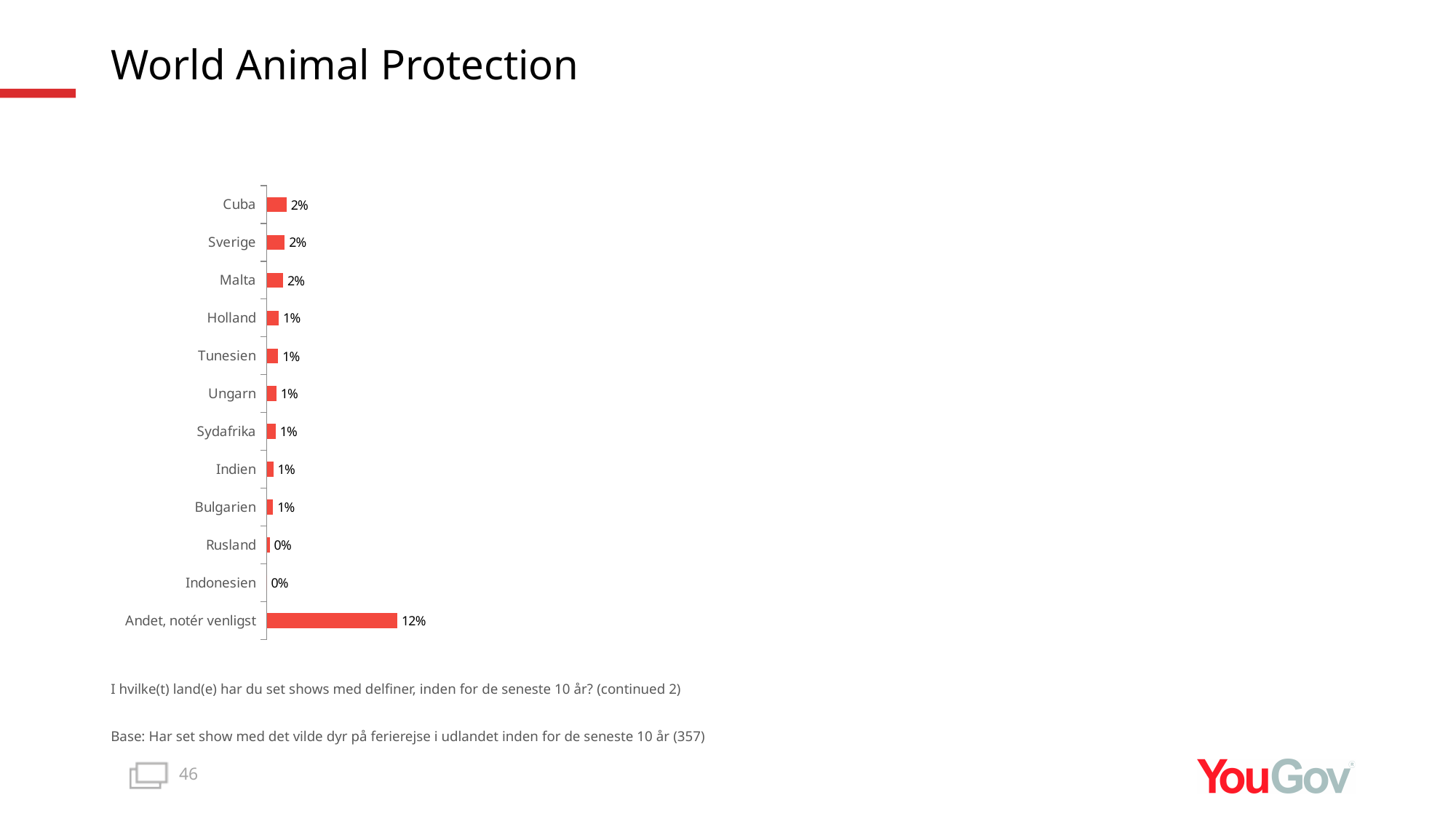
Which category has the highest value? Andet, notér venligst What is the value for Malta? 2% What kind of chart is shown on the slide? Bar chart What is the value for Andet, notér venligst? 12% What is the value for Cuba? 2% What is the value for Indonesien? 0% What colour are the bars in the chart? Red How many categories are shown in the chart? 12 What is the value for Holland? 1% What is the difference between the value for Andet, notér venligst and the value for Cuba? 10 percentage points Which is larger, the value for Cuba or the value for Bulgarien? Cuba What is the difference between the value for Sverige and the value for Tunesien? 1 percentage point